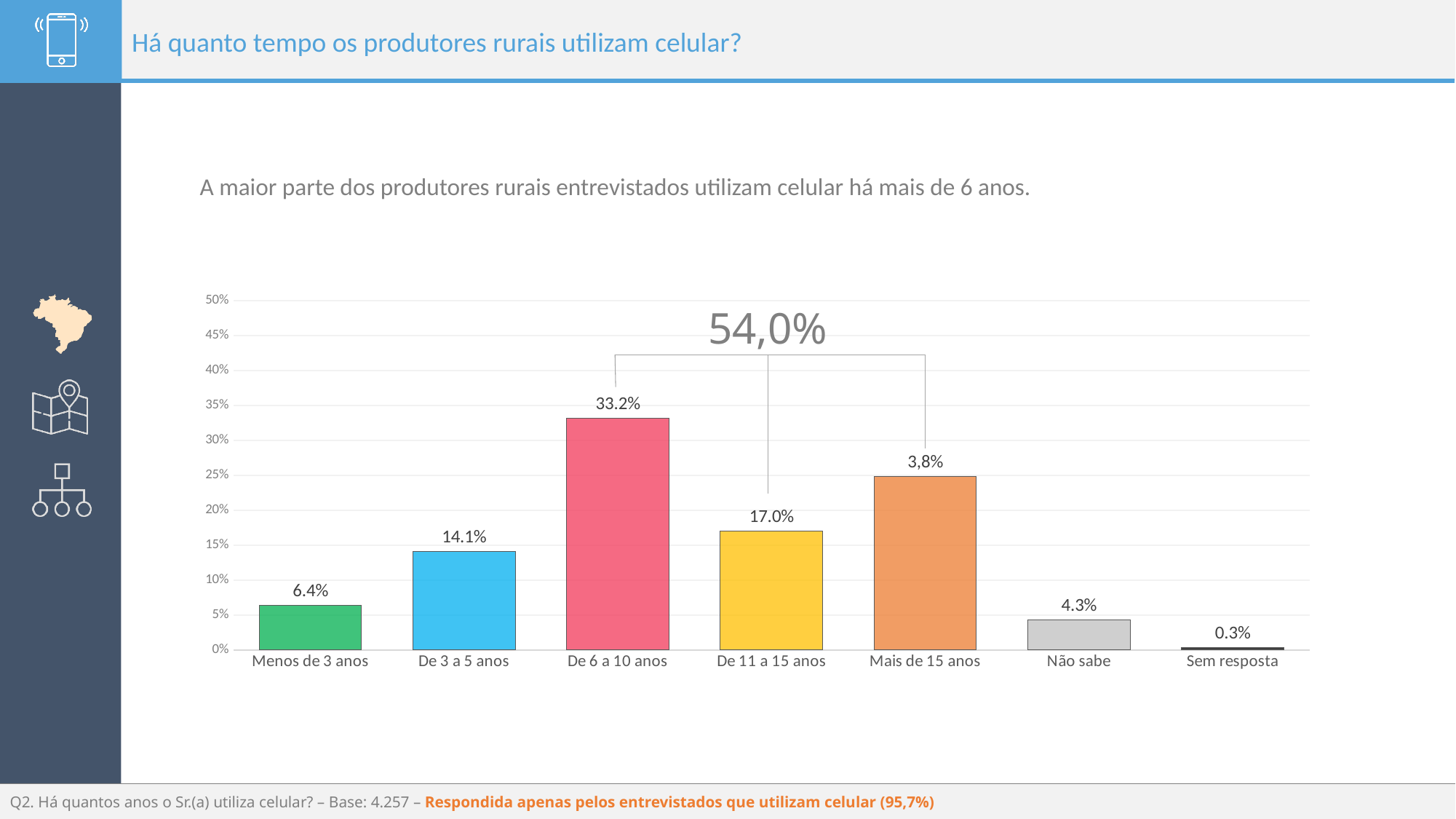
What is the difference between the values for 'De 6 a 10 anos' and 'De 3 a 5 anos'? 19.1 percentage points What type of chart is shown on the slide? bar chart Is the value for 'Mais de 15 anos' greater or less than 20%? greater Which category has the highest value? De 6 a 10 anos What is the value for 'Menos de 3 anos'? 6.4% Which is larger, the value for 'De 3 a 5 anos' or the value for 'De 11 a 15 anos'? De 11 a 15 anos How many categories are shown on the x axis of the chart? 7 What combined percentage is shown above the bracket spanning 'De 6 a 10 anos' to 'Mais de 15 anos'? 54,0% Which category has the lowest value? Sem resposta What is the value for 'De 6 a 10 anos'? 33.2% What is the value for 'Não sabe'? 4.3% What is the value for 'De 11 a 15 anos'? 17.0%